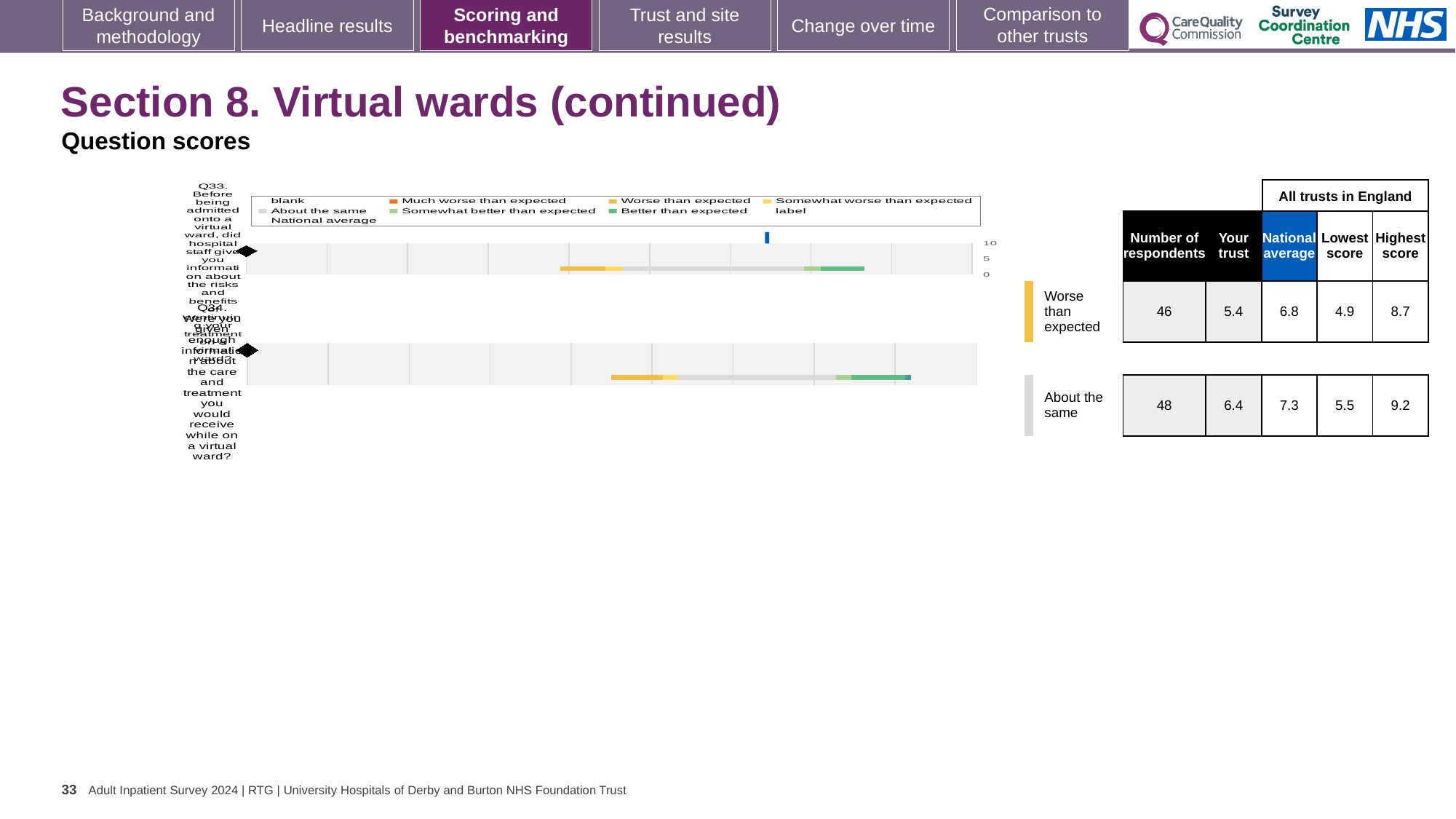
In the table beside the chart, what is the national average for Q34 (About the same)? 7.3 In the table, what is the difference between the lowest scores for Q34 (About the same) and Q33 (Worse than expected)? 0.6 In the table beside the chart, what is the highest score in England for Q34 (About the same)? 9.2 What benchmark category is shown next to the Q33 bar? Worse than expected In the table, what is the difference between the national average and the 'Your trust' score for Q33 (Worse than expected)? 1.4 In the table beside the chart, what is the 'Your trust' score for Q33 (Worse than expected)? 5.4 Which has the larger 'Your trust' score in the table: Q33 (Worse than expected) or Q34 (About the same)? Q34 (About the same) Which question numbers are plotted in the chart? Q33 and Q34 What kind of chart is shown on the slide? bar chart In the table beside the chart, how many respondents are listed for Q33 (Worse than expected)? 46 What benchmark category is shown next to the Q34 bar? About the same How many question bars are plotted in the chart? 2